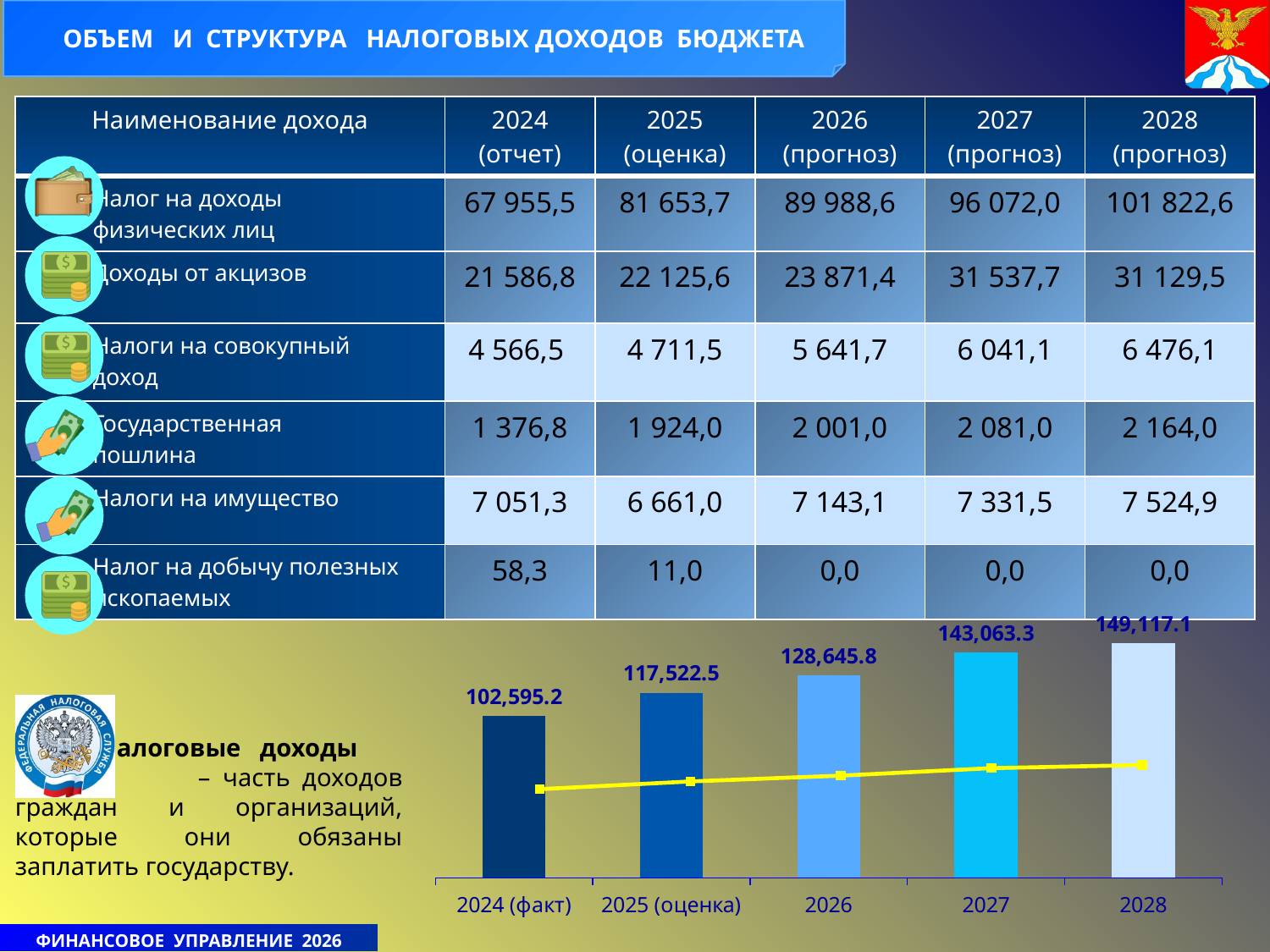
Which bar is larger, 2025 (оценка) or 2026? 2026 What is the value of the bar for 2024 (факт) in the chart? 102,595.2 Which year has the lowest bar in the chart? 2024 (факт) What is the difference between the bar values for 2028 and 2024 (факт)? 46,521.9 What is the value of the bar for 2027 in the chart? 143,063.3 How many bars are shown in the chart? 5 What is the value of the bar for 2026 in the chart? 128,645.8 Which year has the highest bar in the chart? 2028 What is the difference between the bar values for 2027 and 2026? 14,417.5 What is the value of the bar for 2028 in the chart? 149,117.1 What is the value of the bar for 2025 (оценка) in the chart? 117,522.5 Do the bar values rise or fall from 2024 (факт) to 2028? rise